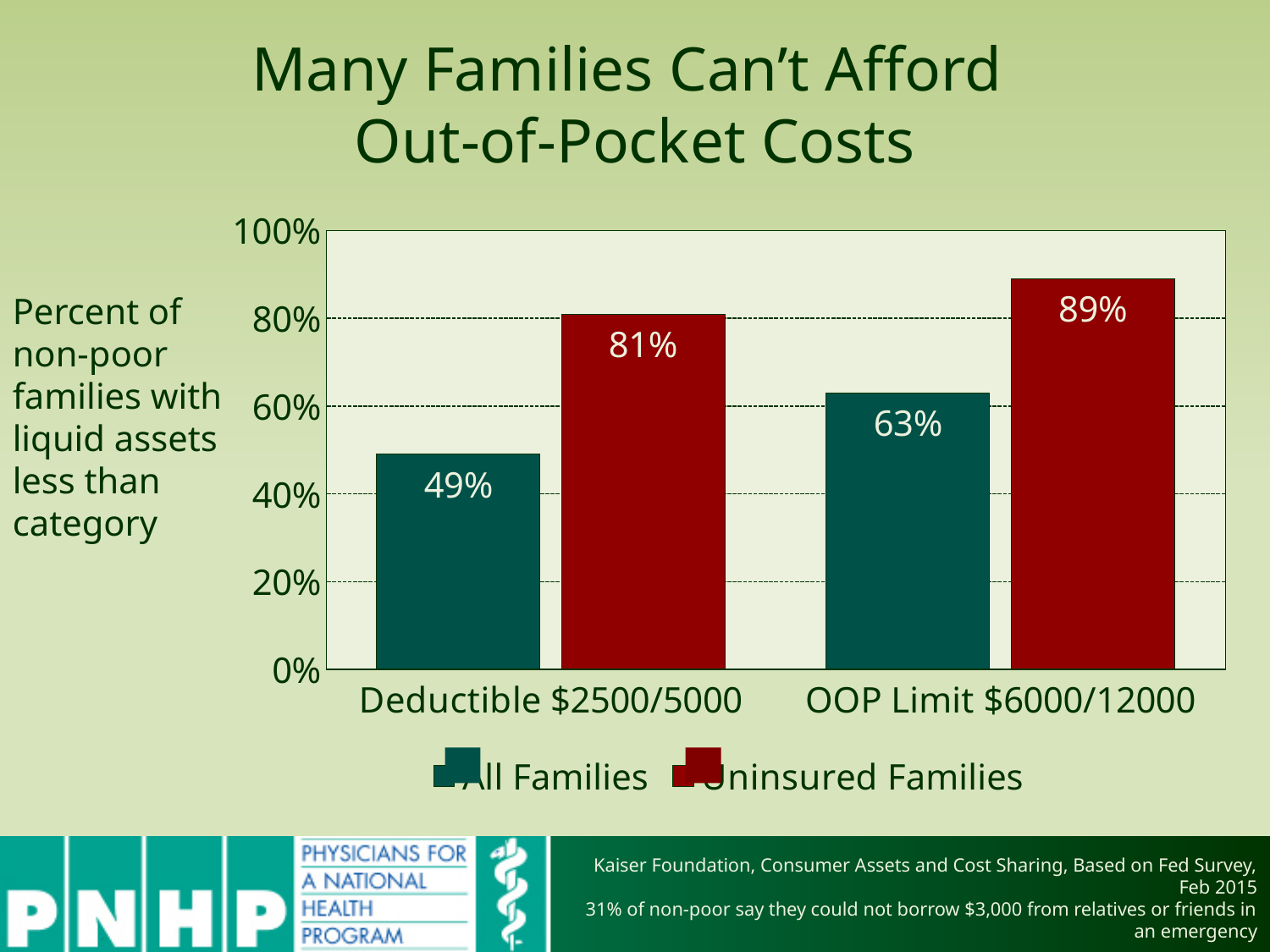
What kind of chart is shown on the slide? Bar chart What is the difference between Uninsured Families and All Families in the Deductible $2500/5000 category? 32% What is the value for All Families in the Deductible $2500/5000 category? 49% Which bar has the lowest value on the chart? All Families, Deductible $2500/5000 What is the value for Uninsured Families in the OOP Limit $6000/12000 category? 89% What is the value for All Families in the OOP Limit $6000/12000 category? 63% How many categories are shown on the x axis? 2 What is the value for Uninsured Families in the Deductible $2500/5000 category? 81% Which bar has the highest value on the chart? Uninsured Families, OOP Limit $6000/12000 Which is larger: All Families for OOP Limit $6000/12000 or Uninsured Families for Deductible $2500/5000? Uninsured Families for Deductible $2500/5000 What is the difference between Uninsured Families and All Families in the OOP Limit $6000/12000 category? 26% How many series does the legend list? 2